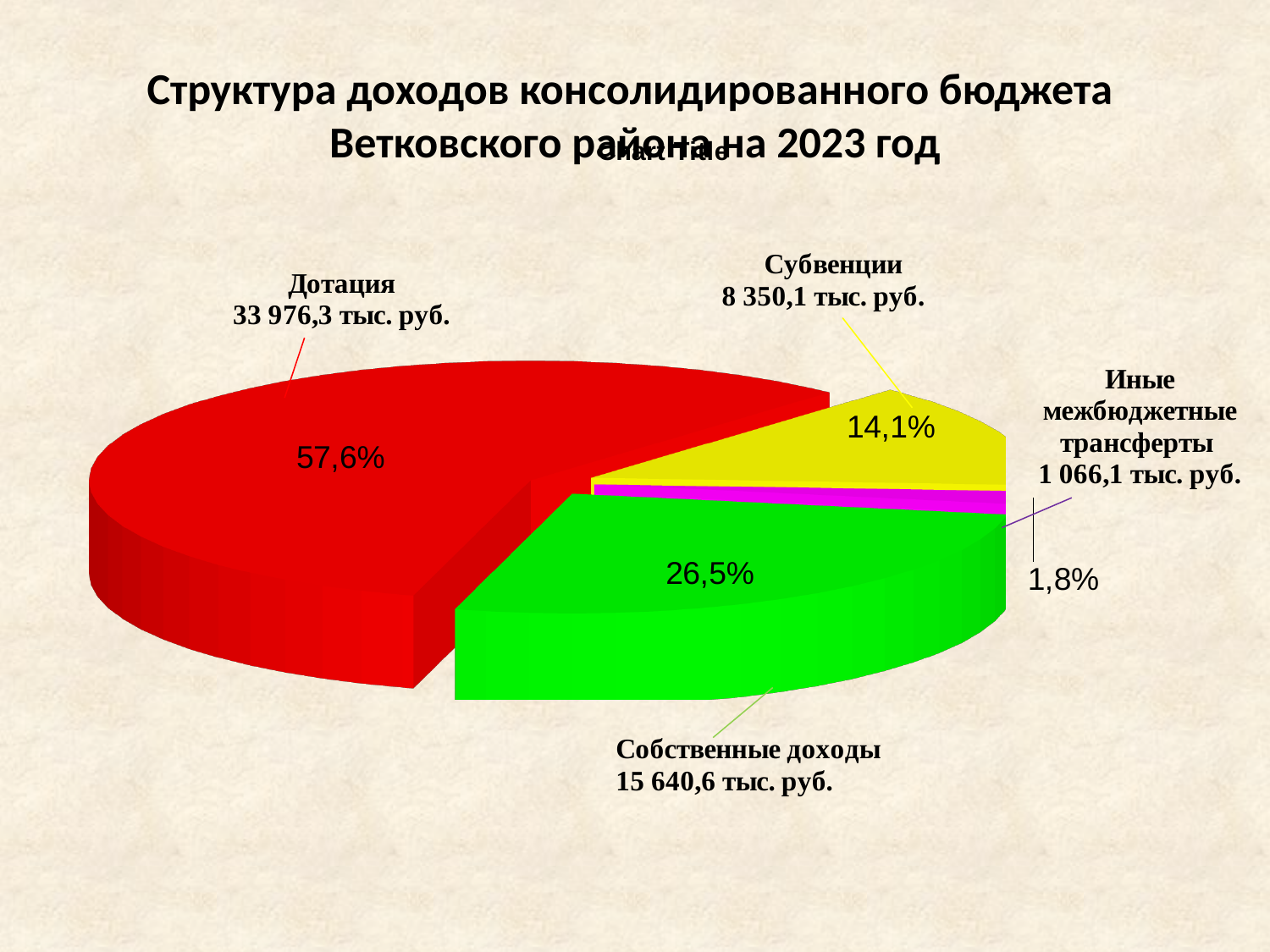
What share of the pie does Собственные доходы represent? 26,5% What share of the pie does Дотация represent? 57,6% How many slices does the pie chart have? 4 Which category has the smallest slice of the pie? Иные межбюджетные трансферты What is the value shown for Иные межбюджетные трансферты? 1 066,1 тыс. руб. What kind of chart is shown on the slide? Pie chart What is the difference between the values for Дотация and Собственные доходы? 18 335,7 тыс. руб. What is the value shown for Собственные доходы? 15 640,6 тыс. руб. Which category has the largest slice of the pie? Дотация What share of the pie does Субвенции represent? 14,1% Which is larger, Субвенции or Собственные доходы? Собственные доходы What is the value shown for Дотация? 33 976,3 тыс. руб.